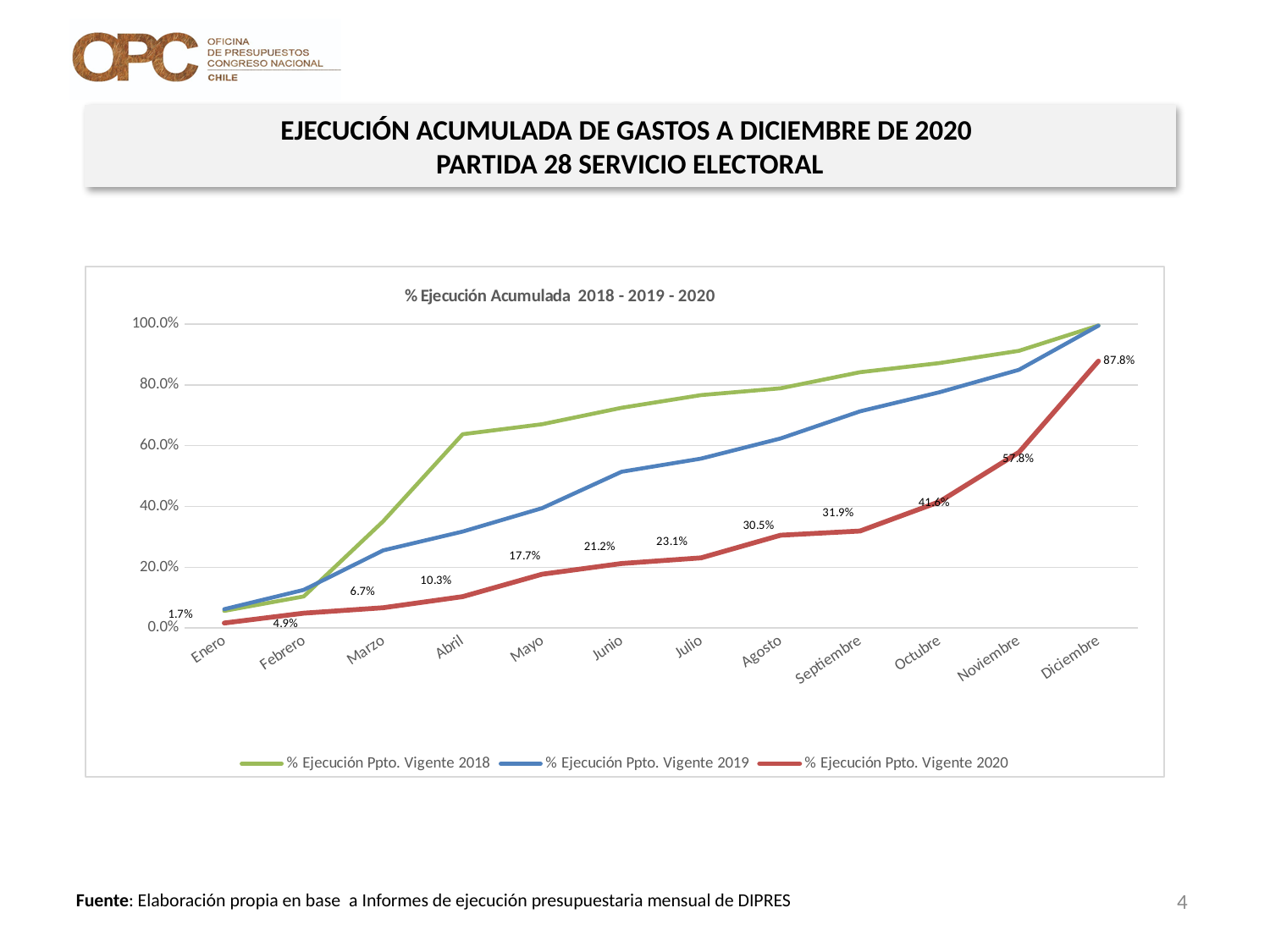
Does the % Ejecución Ppto. Vigente 2020 series rise or fall from Enero to Diciembre? rise What is the value for % Ejecución Ppto. Vigente 2020 in Enero? 1.7% How many series does the legend list? 3 What is the difference between the % Ejecución Ppto. Vigente 2020 values for Diciembre and Noviembre? 30.0% What is the value for % Ejecución Ppto. Vigente 2020 in Mayo? 17.7% What is the value for % Ejecución Ppto. Vigente 2020 in Diciembre? 87.8% How many months are shown on the x axis? 12 In which month is the % Ejecución Ppto. Vigente 2020 value lowest? Enero Is the value for % Ejecución Ppto. Vigente 2019 in Junio greater or less than 40.0%? greater What type of chart is shown on the slide? line chart In Abril, which series has the higher value: % Ejecución Ppto. Vigente 2018 or % Ejecución Ppto. Vigente 2020? % Ejecución Ppto. Vigente 2018 What is the value for % Ejecución Ppto. Vigente 2020 in Octubre? 41.6%